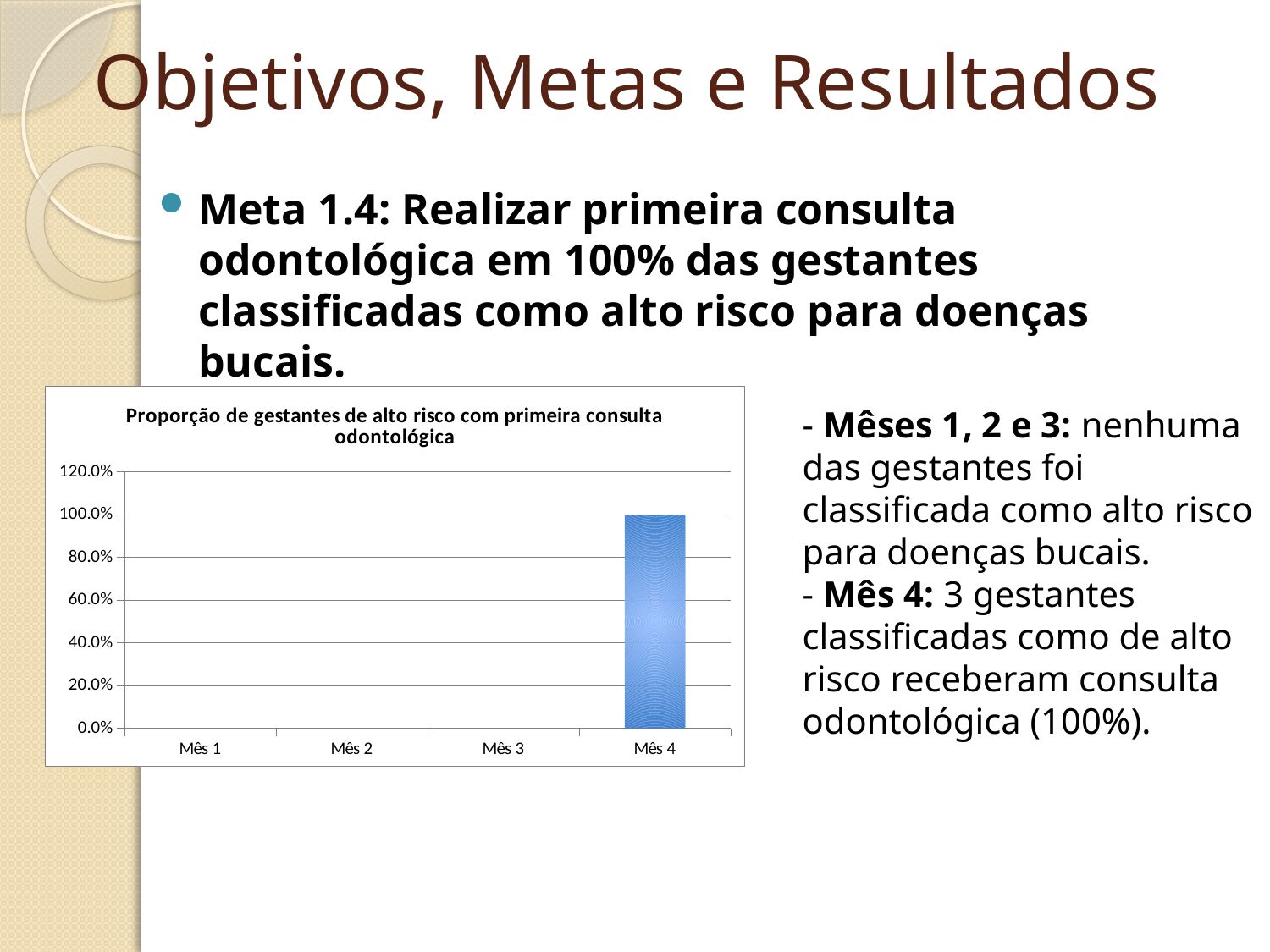
What is the difference between the value for Mês 4 and the value for Mês 3? 100.0% Is the value for Mês 4 greater or less than 80.0%? greater What is the value for Mês 4 in the chart? 100.0% What is the value for Mês 2 in the chart? 0.0% Which is larger, the value for Mês 1 or the value for Mês 4? Mês 4 What is the title of the chart? Proporção de gestantes de alto risco com primeira consulta odontológica Do the values rise or fall from Mês 1 to Mês 4? rise What is the highest tick value shown on the y axis of the chart? 120.0% What kind of chart is shown on the slide? bar chart Which month has the highest value in the chart? Mês 4 How many categories (months) are shown on the x axis of the chart? 4 How many months in the chart have a visible bar above 0.0%? 1